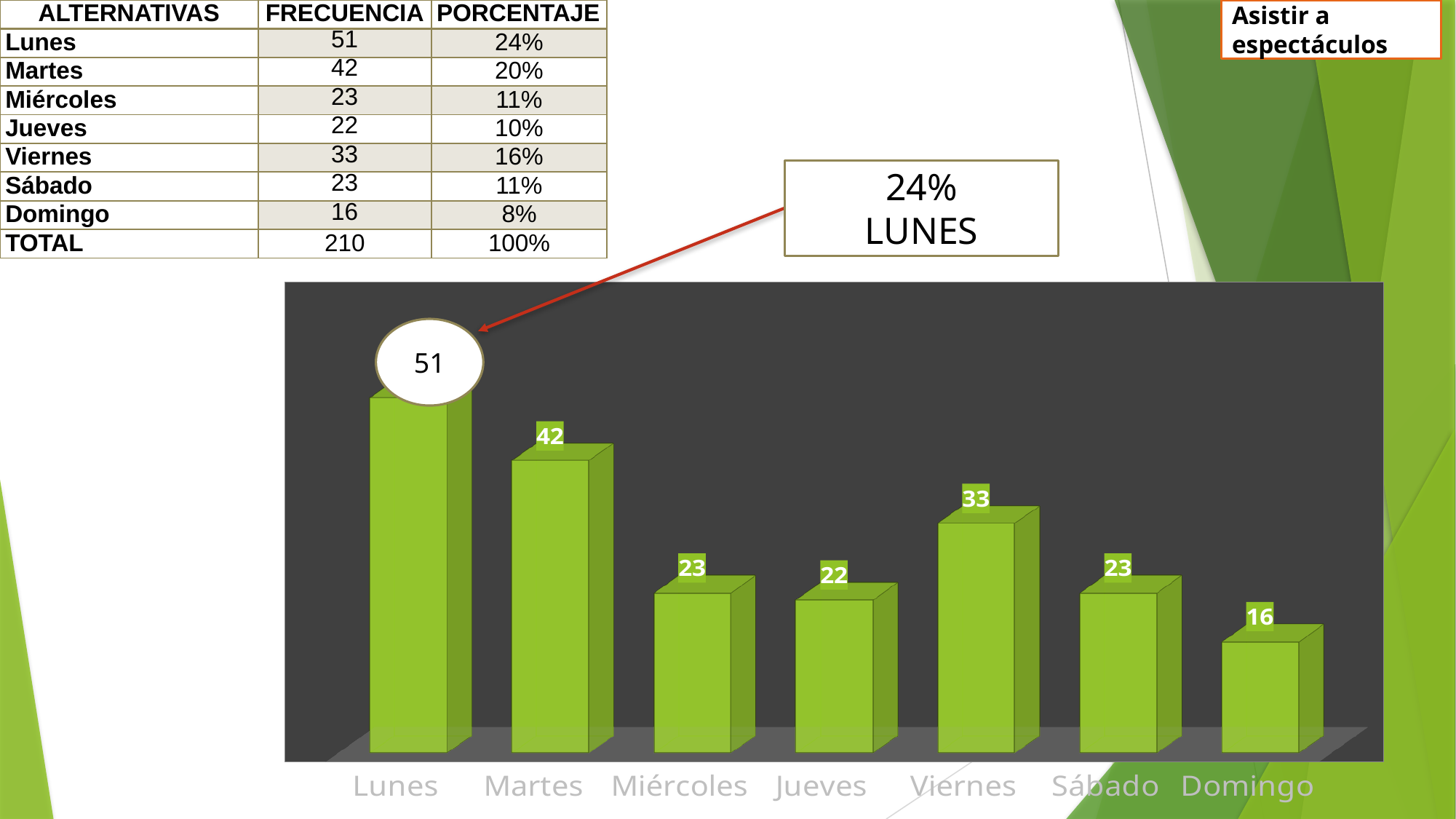
Which two days have the same value of 23? Miércoles and Sábado What is the value of the bar for Martes? 42 What percentage does the callout box above the chart attribute to Lunes? 24% Which is larger, the value for Viernes or the value for Jueves? Viernes Which day has the lowest bar? Domingo What is the difference between the values for Viernes and Domingo? 17 What is the difference between the values for Lunes and Martes? 9 How many bars are shown in the chart? 7 What is the value of the bar for Domingo? 16 Which day has the highest bar? Lunes What is the value of the bar for Viernes? 33 What kind of chart is shown on the slide? bar chart